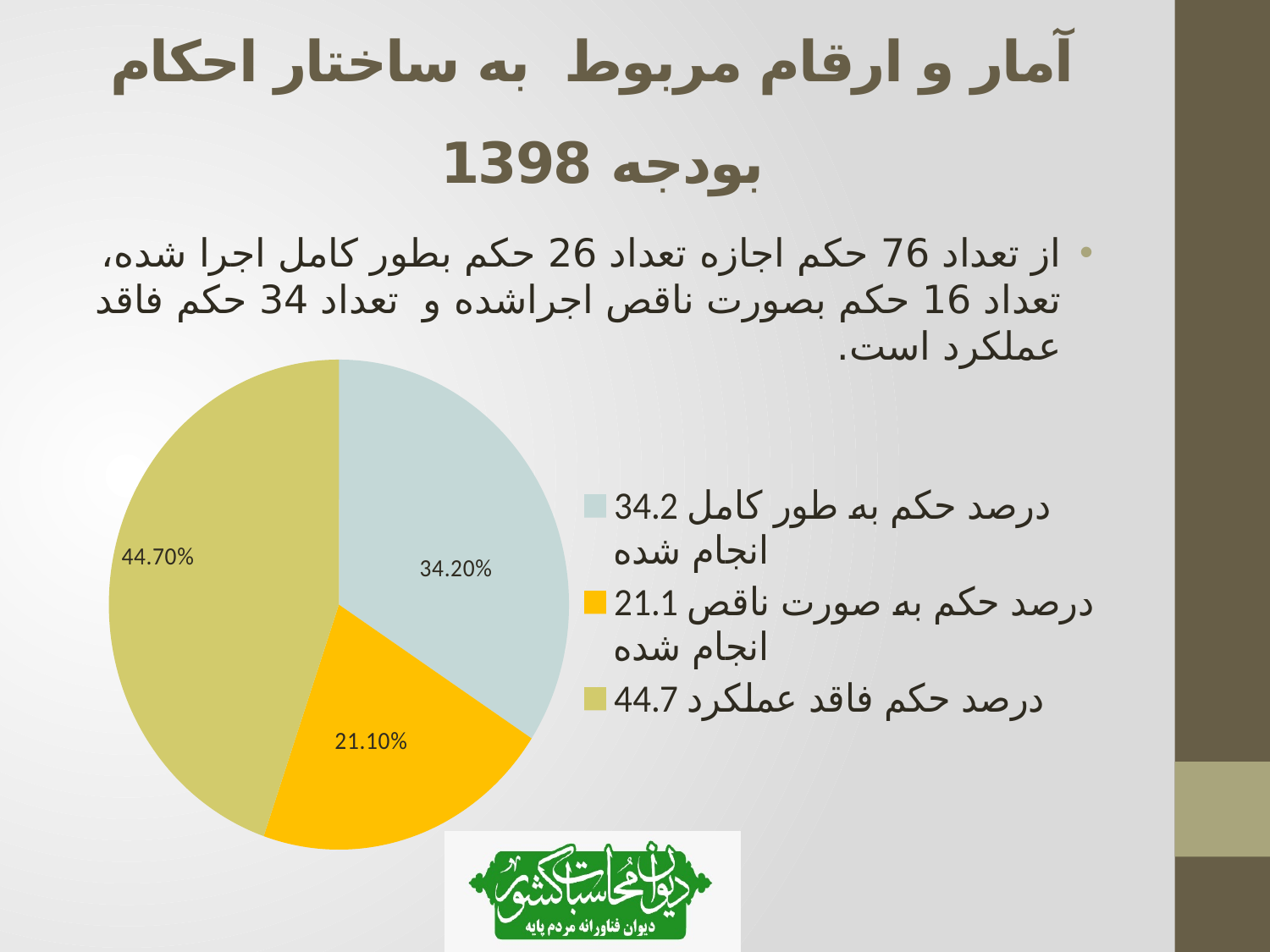
Which is larger: the slice for "درصد حکم به طور کامل انجام شده" or the slice for "درصد حکم به صورت ناقص انجام شده"? درصد حکم به طور کامل انجام شده What is the data label on the slice for "درصد حکم به صورت ناقص انجام شده"? 21.10% What is the data label on the slice for "درصد حکم به طور کامل انجام شده"? 34.20% What share of the pie does the "درصد حکم به صورت ناقص انجام شده" slice represent? 21.10% How many entries does the legend of the pie chart list? 3 What is the difference between the slice for "درصد حکم فاقد عملکرد" and the slice for "درصد حکم به طور کامل انجام شده"? 10.50% What colour is the slice for "درصد حکم به صورت ناقص انجام شده"? yellow What kind of chart is shown on the slide? pie chart Which category has the largest slice of the pie? درصد حکم فاقد عملکرد Which category has the smallest slice of the pie? درصد حکم به صورت ناقص انجام شده What is the data label on the slice for "درصد حکم فاقد عملکرد"? 44.70% How many slices does the pie chart have? 3